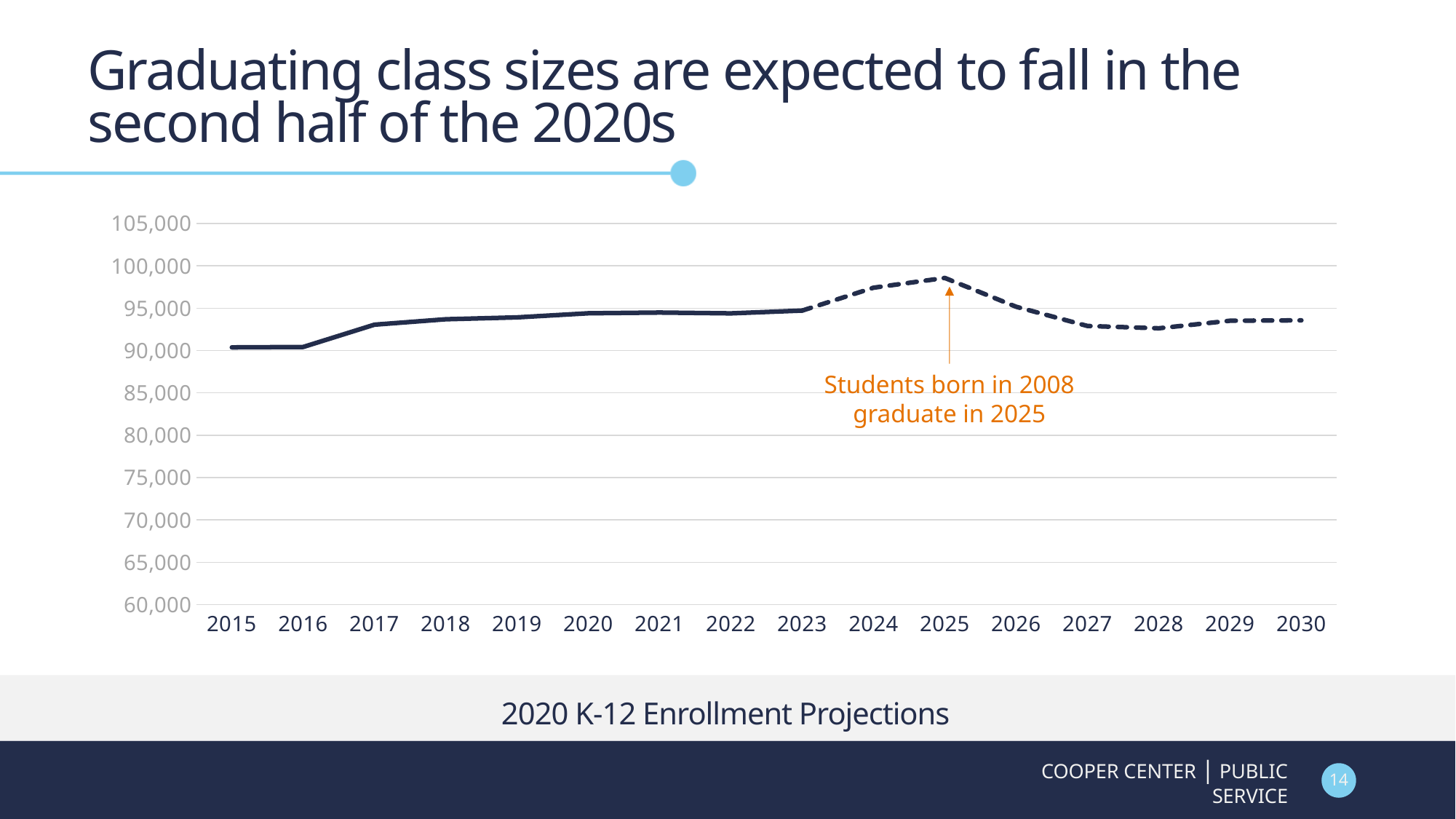
Which year has the larger value, 2015 or 2017? 2017 Is the value for 2028 greater or less than 95,000? less Which year has the larger value, 2025 or 2028? 2025 What kind of chart is shown on the slide? line chart How many years are shown on the x axis of the chart? 16 What does the orange annotation on the chart say? Students born in 2008 graduate in 2025 Is the value for 2025 greater or less than 95,000? greater Is the value for 2025 greater or less than 100,000? less In which year does the line reach its highest value? 2025 Do the values rise or fall between 2025 and 2027? fall